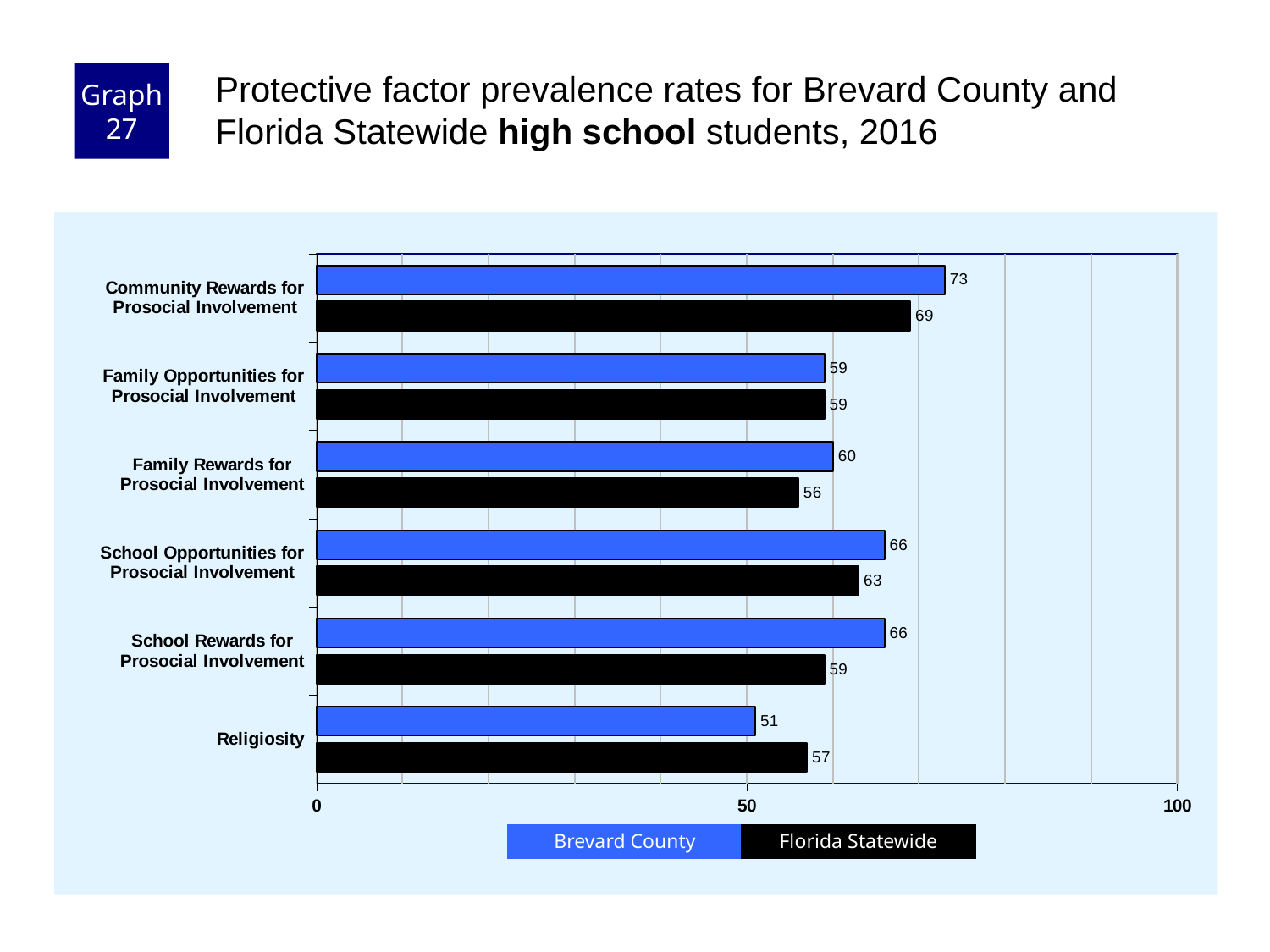
Which category has the highest Brevard County value? Community Rewards for Prosocial Involvement What is the Florida Statewide value for Religiosity? 57 What is the difference between the Brevard County and Florida Statewide values for School Rewards for Prosocial Involvement? 7 Which category has the lowest Florida Statewide value? Family Rewards for Prosocial Involvement What is the Brevard County value for Community Rewards for Prosocial Involvement? 73 Which colour represents Florida Statewide in the chart? Black What kind of chart is shown on the slide? Bar chart How many series does the legend list? 2 Which category has the lowest Brevard County value? Religiosity How many protective factor categories are shown on the chart? 6 What is the Florida Statewide value for School Opportunities for Prosocial Involvement? 63 For Religiosity, which is larger: the Brevard County value or the Florida Statewide value? Florida Statewide